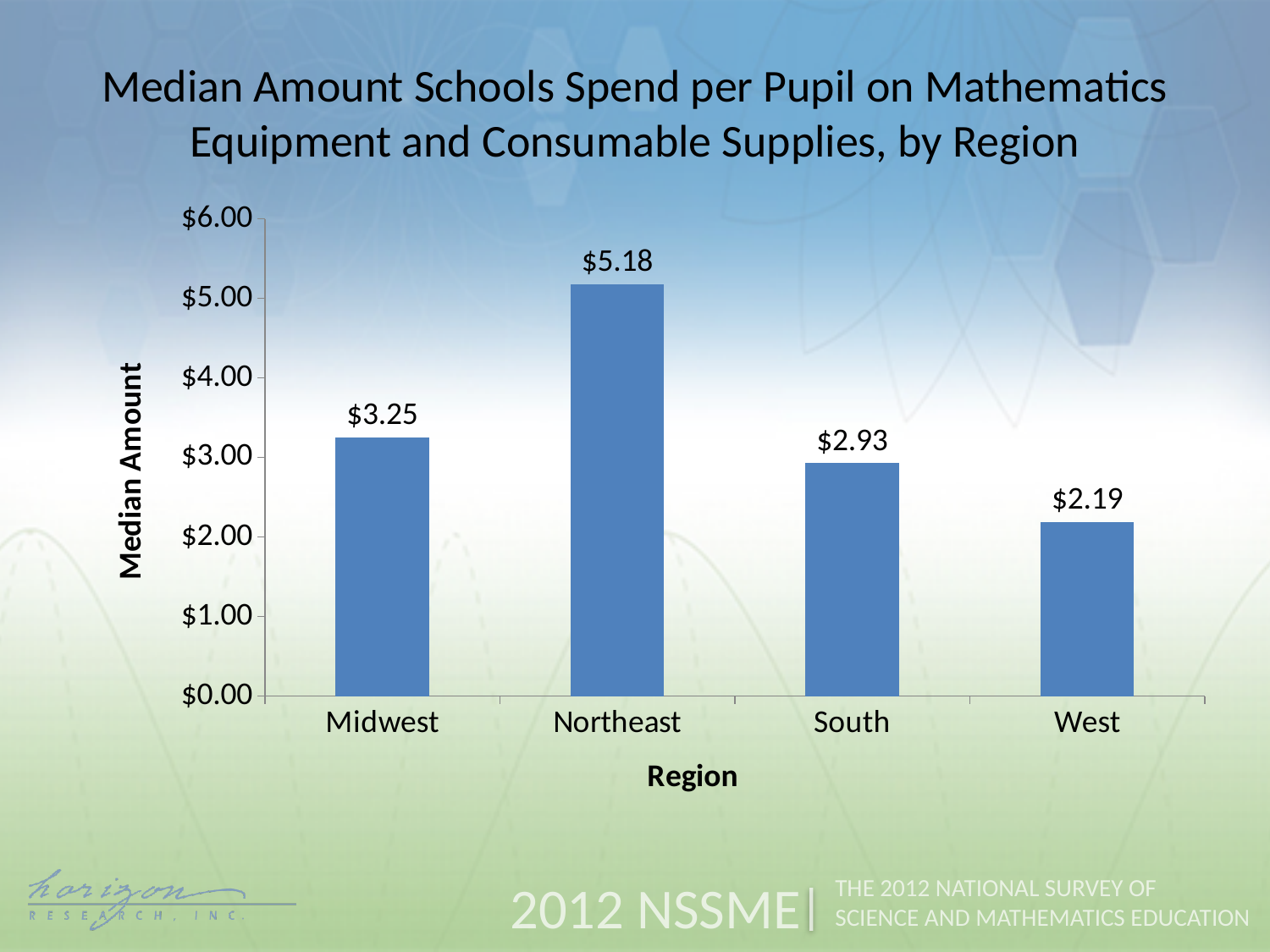
Which region has the lowest median amount spent per pupil? West What is the median amount spent per pupil in the Midwest? $3.25 What is the difference between the median amounts for the Midwest and the South? $0.32 What is the median amount spent per pupil in the West? $2.19 What is the difference between the median amounts for the Northeast and the West? $2.99 What is the median amount spent per pupil in the Northeast? $5.18 Is the value for the Northeast greater or less than $5.00? greater Which region has a larger median amount, Midwest or South? Midwest What kind of chart is shown on the slide? Bar chart Which region has the highest median amount spent per pupil? Northeast How many regions are shown on the chart? 4 What is the median amount spent per pupil in the South? $2.93